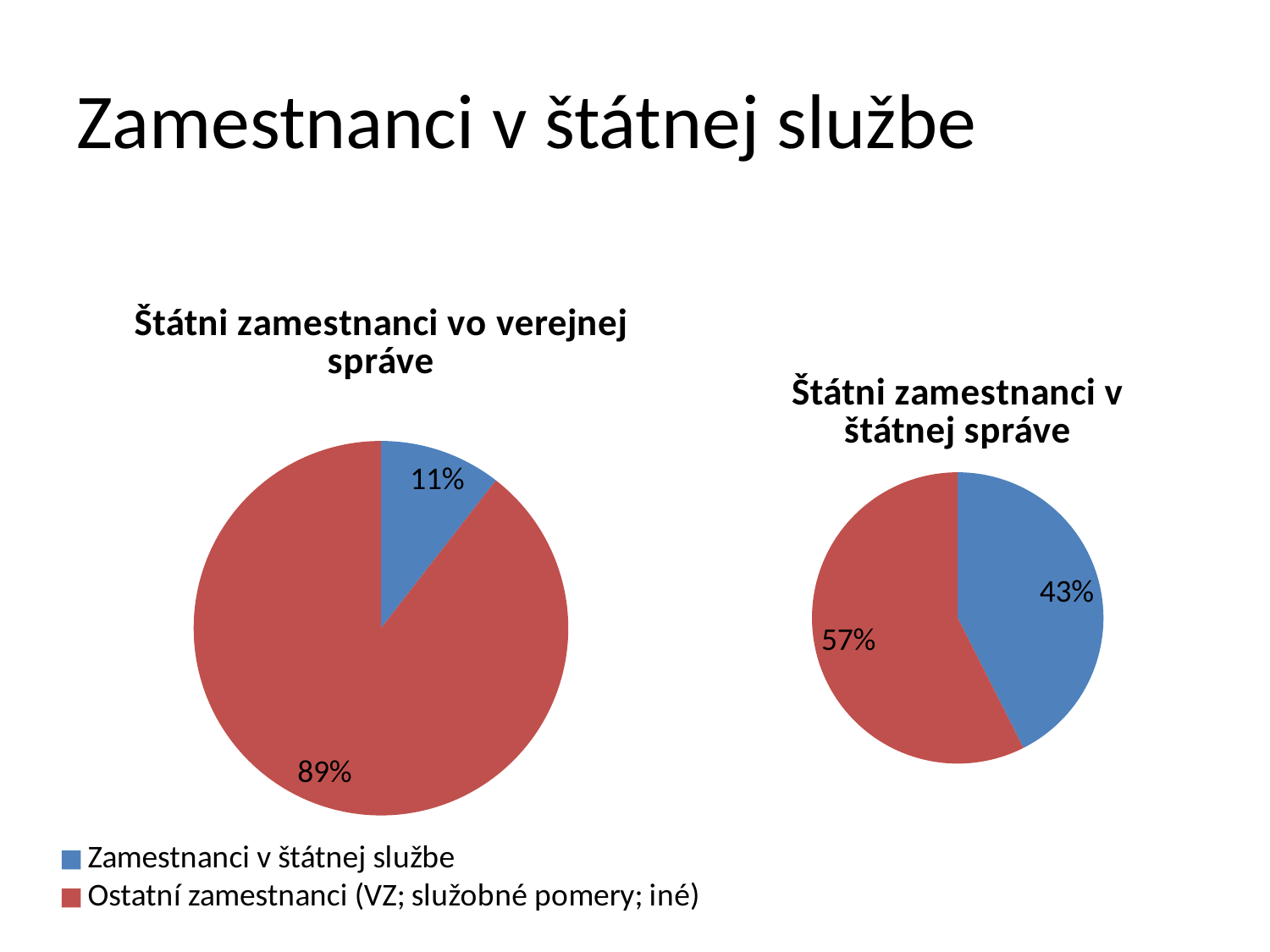
In the chart titled "Štátni zamestnanci vo verejnej správe", what share is labelled for Zamestnanci v štátnej službe? 11% Which chart shows a larger share for Zamestnanci v štátnej službe, the left one or the right one? the right one What colour represents Zamestnanci v štátnej službe in the charts? blue In the chart on the left, which category has the largest slice? Ostatní zamestnanci (VZ; služobné pomery; iné) In the chart titled "Štátni zamestnanci v štátnej správe", what is the difference in percentage points between the two slices? 14 What type of chart is used on this slide? pie chart How many categories does the legend list? 2 In the chart titled "Štátni zamestnanci vo verejnej správe", what share is labelled for Ostatní zamestnanci (VZ; služobné pomery; iné)? 89% In the chart titled "Štátni zamestnanci vo verejnej správe", what is the difference in percentage points between the two slices? 78 In the chart titled "Štátni zamestnanci v štátnej správe", what share is labelled for Ostatní zamestnanci (VZ; služobné pomery; iné)? 57% In the chart on the right, which category has the smallest slice? Zamestnanci v štátnej službe In the chart titled "Štátni zamestnanci v štátnej správe", what share is labelled for Zamestnanci v štátnej službe? 43%